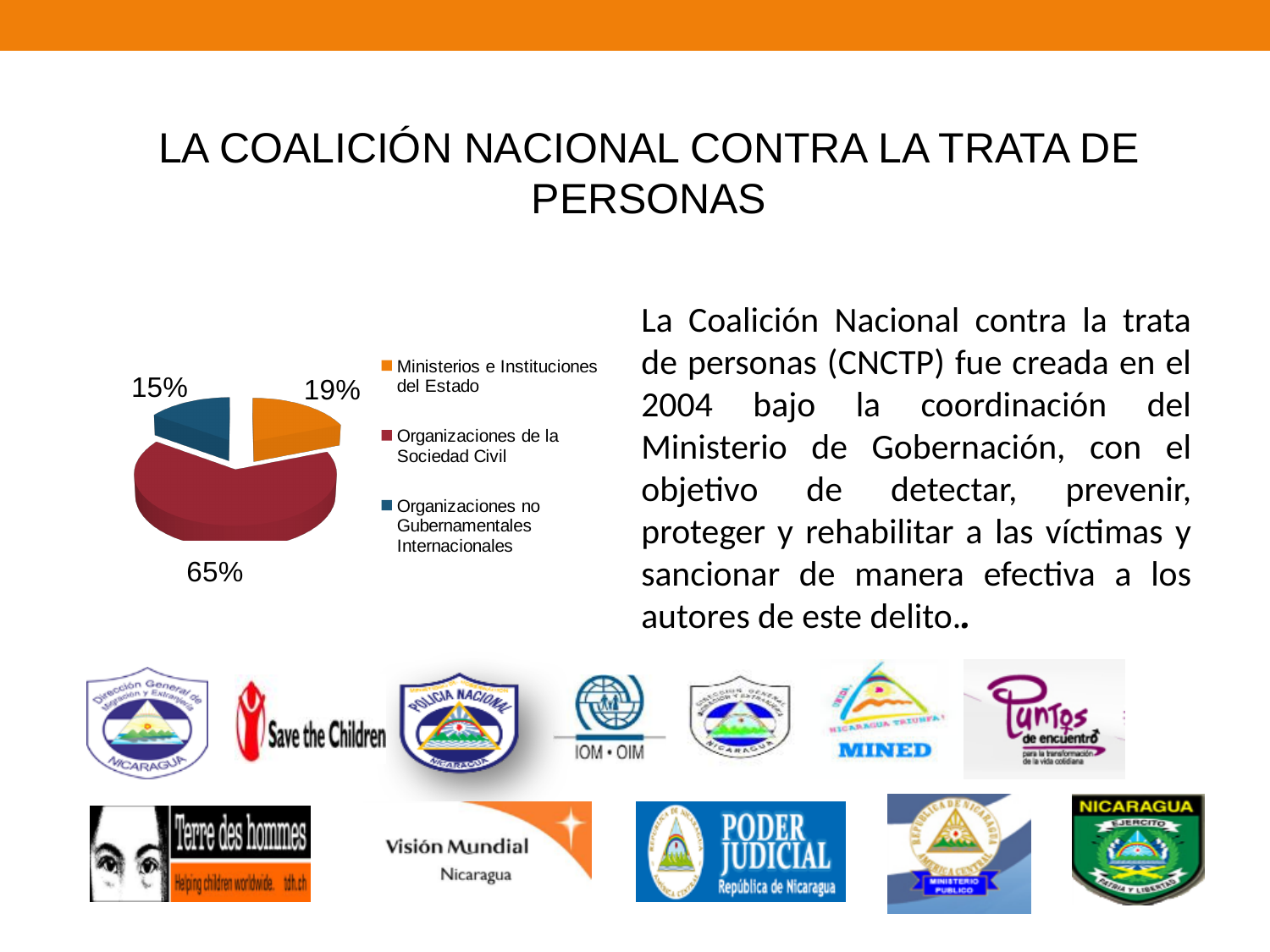
How many slices does the pie chart have? 3 Which category has the largest share in the pie chart? Organizaciones de la Sociedad Civil What is the difference in percentage points between Organizaciones de la Sociedad Civil and Ministerios e Instituciones del Estado? 46 How many entries does the legend of the pie chart list? 3 What colour is the slice for Ministerios e Instituciones del Estado in the pie chart? Orange What colour is the slice for Organizaciones de la Sociedad Civil in the pie chart? Red What percentage does the pie chart show for Organizaciones de la Sociedad Civil? 65% What percentage does the pie chart show for Organizaciones no Gubernamentales Internacionales? 15% What percentage does the pie chart show for Ministerios e Instituciones del Estado? 19% What type of chart is shown on the slide? Pie chart Which category has the smallest share in the pie chart? Organizaciones no Gubernamentales Internacionales Which is larger in the pie chart: Ministerios e Instituciones del Estado or Organizaciones no Gubernamentales Internacionales? Ministerios e Instituciones del Estado